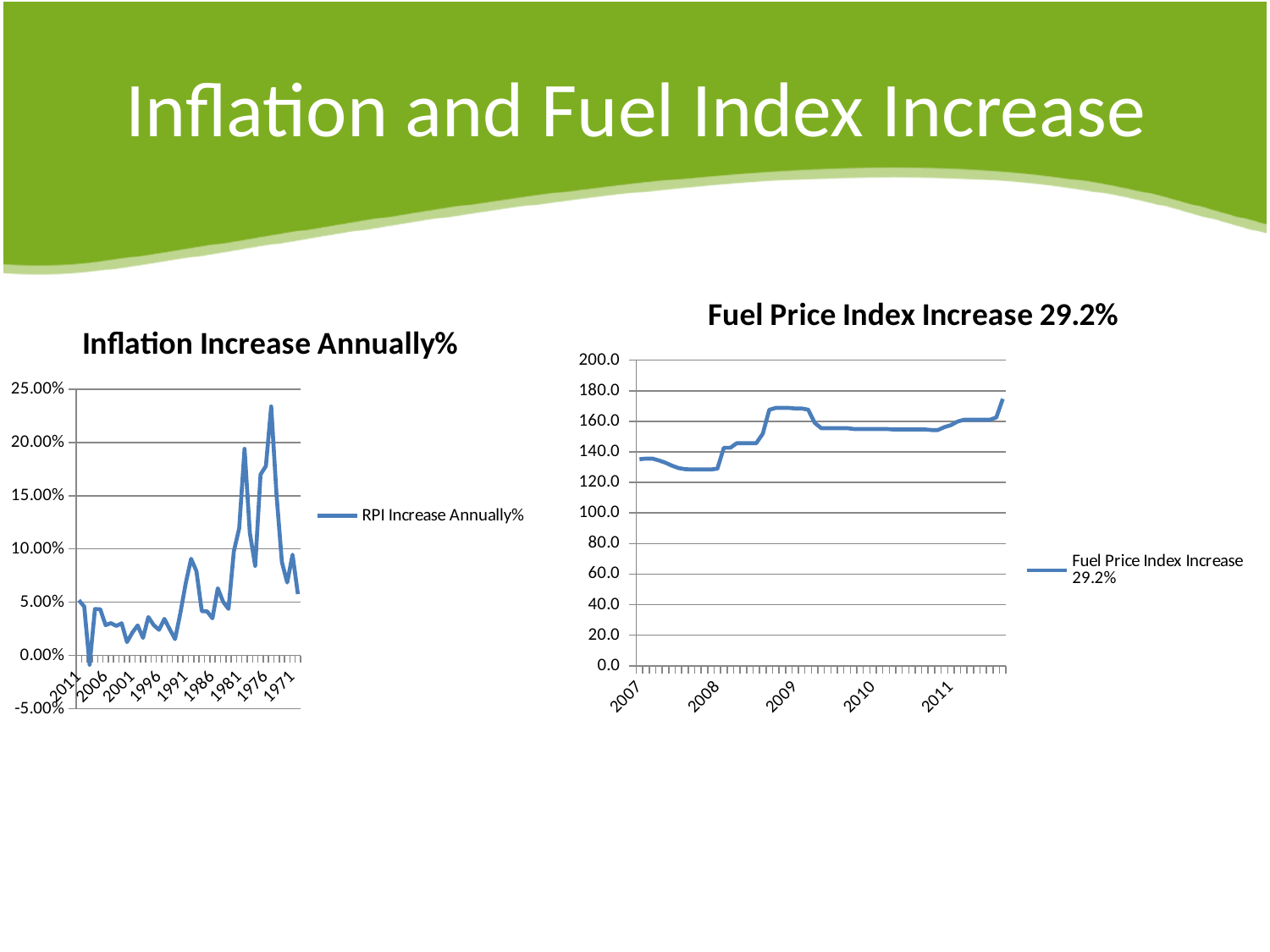
What is the title of the chart on the right of the slide? Fuel Price Index Increase 29.2% In the 'Fuel Price Index Increase 29.2%' chart, is the value at the 2011 tick greater or less than 140.0? greater In the 'Fuel Price Index Increase 29.2%' chart, does the line generally rise or fall from 2007 to 2011? rise What kind of chart is the 'Fuel Price Index Increase 29.2%' chart? line chart How many series does the legend of the 'Inflation Increase Annually%' chart list? 1 In the 'Fuel Price Index Increase 29.2%' chart, in which year does the line reach its highest value? 2011 What is the legend entry on the 'Inflation Increase Annually%' chart? RPI Increase Annually% In the 'Inflation Increase Annually%' chart, is the highest peak of the line greater or less than 20.00%? greater What kind of chart is the 'Inflation Increase Annually%' chart? line chart In the 'Inflation Increase Annually%' chart, is the value at the 2011 tick greater or less than 10.00%? less